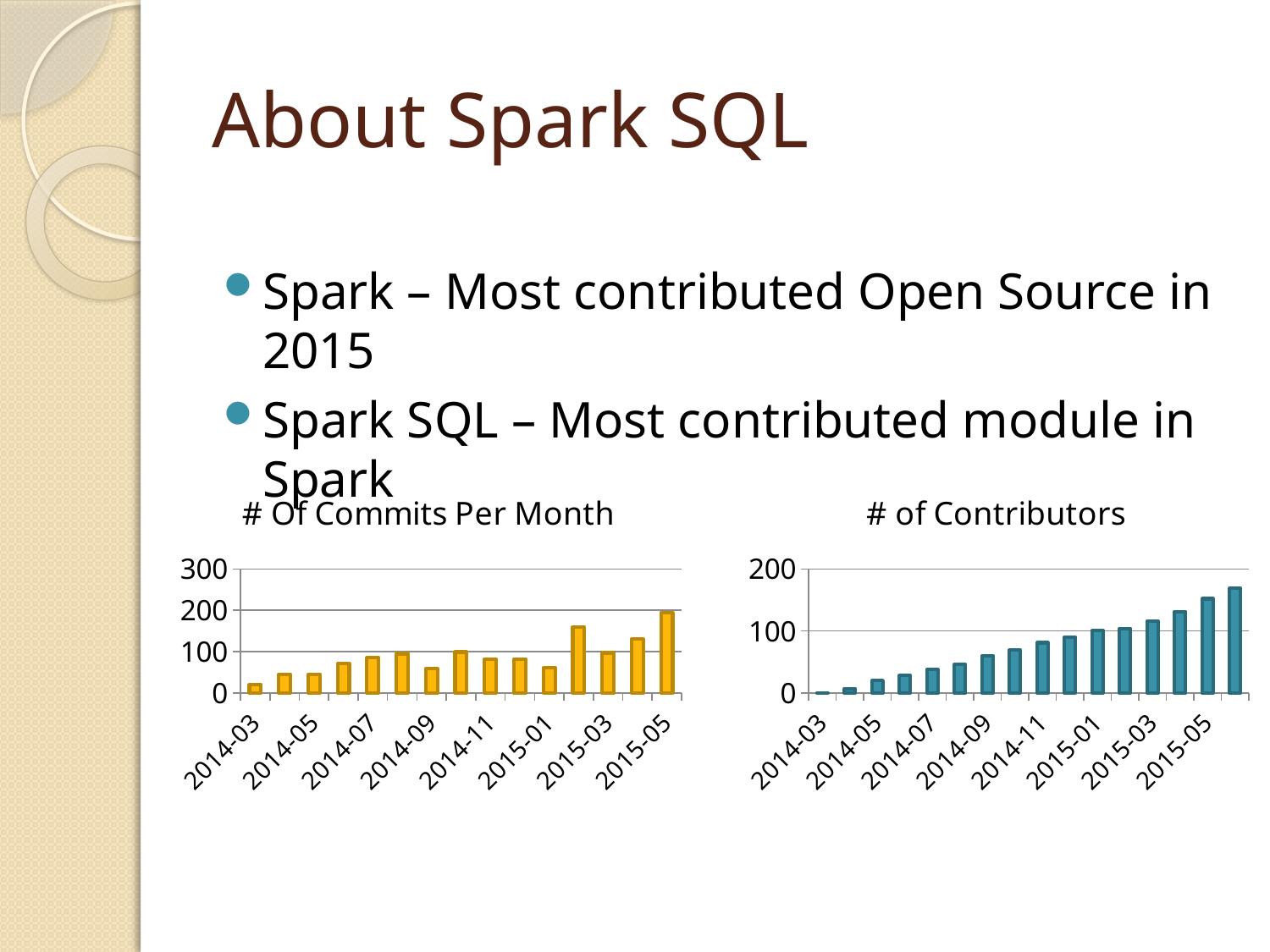
In the '# Of Commits Per Month' chart, which month has the highest number of commits? 2015-05 In the '# Of Commits Per Month' chart, which month has the lowest number of commits? 2014-03 In the '# of Contributors' chart, is the value for 2014-03 greater or less than 100? less What kind of chart is the '# Of Commits Per Month' chart? bar chart What kind of chart is the '# of Contributors' chart? bar chart In the '# of Contributors' chart, is the value for 2015-05 greater or less than 100? greater In the '# of Contributors' chart, do the values generally rise or fall from 2014-03 to 2015-05? rise In the '# Of Commits Per Month' chart, is the value for 2015-05 greater or less than 100? greater What is the title of the chart on the right side of the slide? # of Contributors In the '# Of Commits Per Month' chart, which is larger, the value for 2015-05 or the value for 2014-03? 2015-05